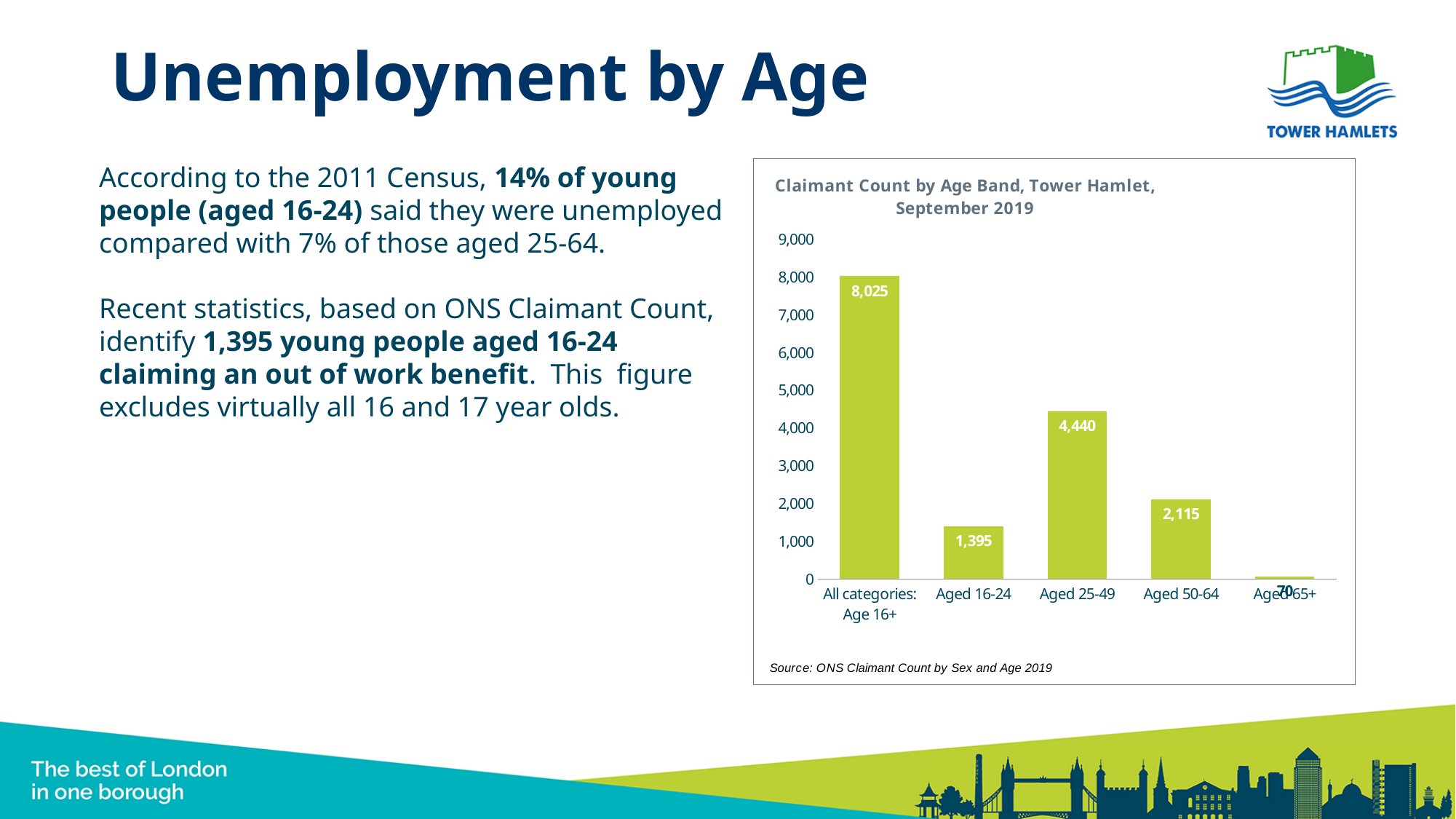
What is the claimant count for Aged 25-49? 4,440 How many categories are shown on the x axis of the chart? 5 What kind of chart is shown on the slide? Bar chart What is the difference between the claimant counts for Aged 25-49 and Aged 16-24? 3,045 Is the value for Aged 25-49 greater or less than 4,000? greater What is the claimant count for Aged 50-64? 2,115 What is the title of the chart? Claimant Count by Age Band, Tower Hamlet, September 2019 Which is larger, the claimant count for Aged 50-64 or for Aged 16-24? Aged 50-64 What is the claimant count for Aged 16-24? 1,395 Which age band has the lowest claimant count? Aged 65+ Which category has the highest bar in the chart? All categories: Age 16+ What is the claimant count for All categories: Age 16+? 8,025